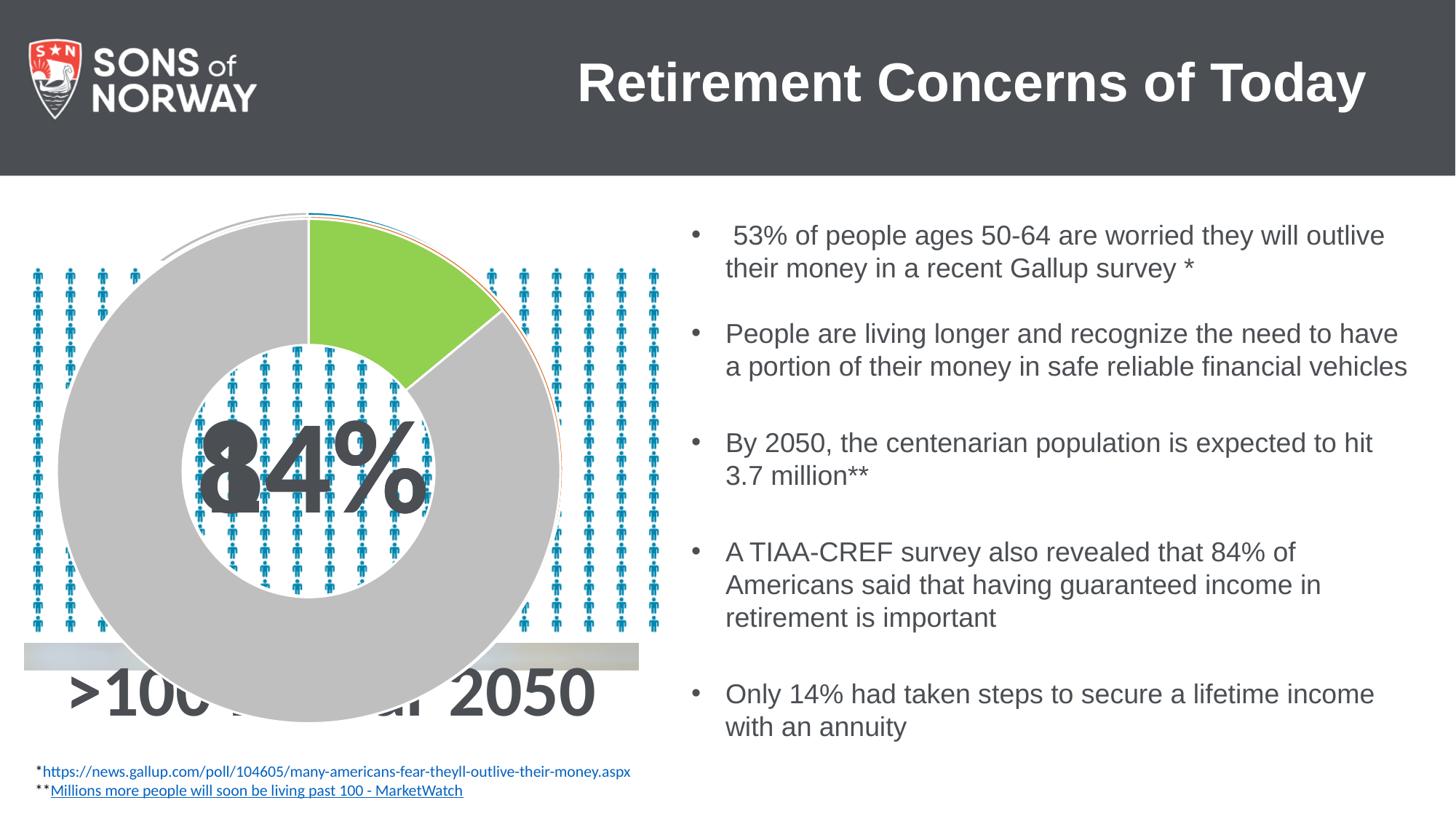
In the donut chart on the left of the slide, which colour is the largest slice? gray What kind of chart is shown on the left of the slide? pie chart (donut) In the donut chart on the left of the slide, which colour is the smaller slice? green In the donut chart on the left of the slide, which slice is larger, the green one or the gray one? the gray one What colours are the two slices of the donut chart on the left of the slide? green and gray How many slices does the donut chart on the left of the slide have? 2